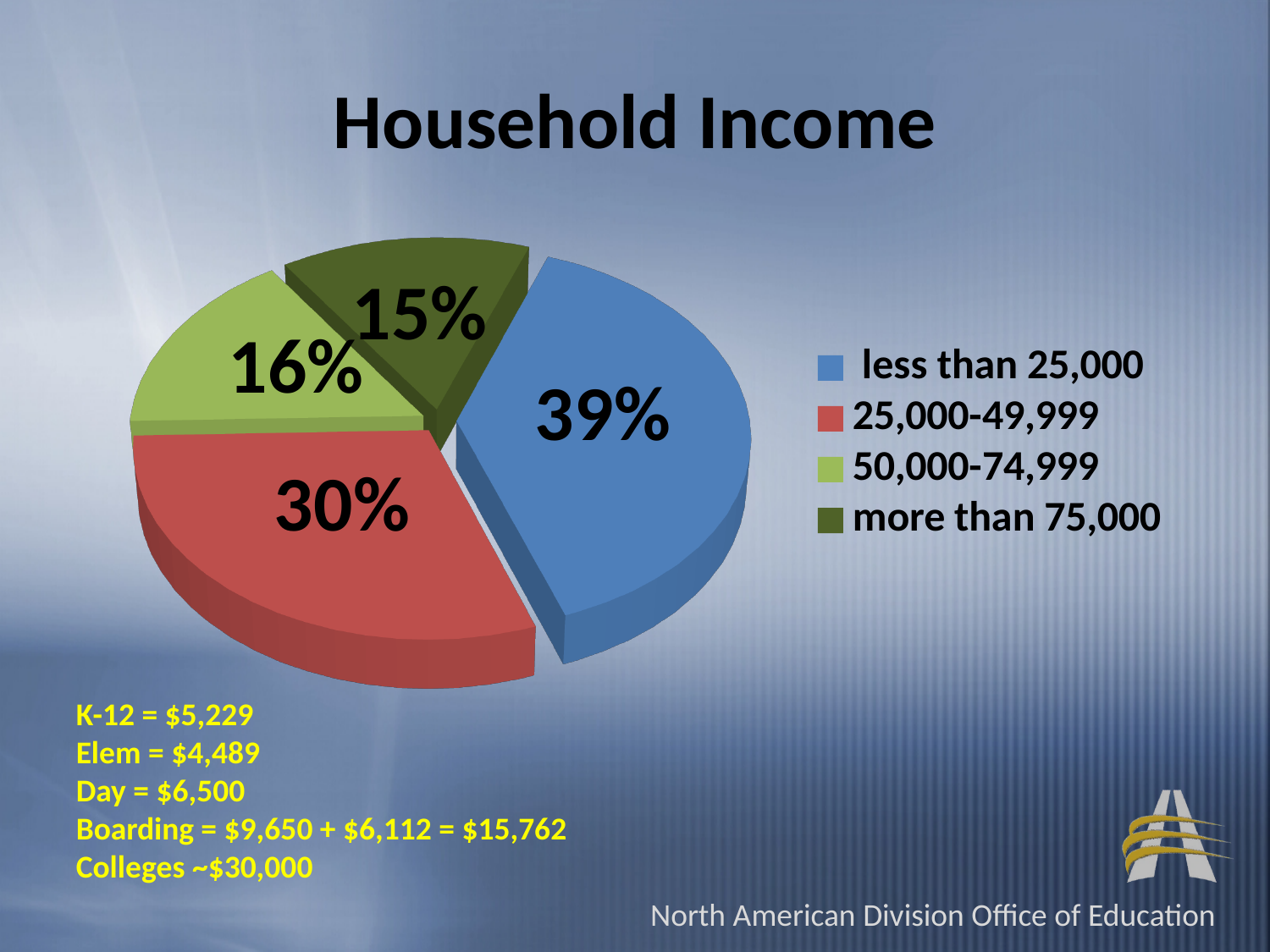
What percentage is shown for the '50,000-74,999' category? 16% What colour is the slice for 'less than 25,000'? blue Which is larger, the share for '25,000-49,999' or the share for '50,000-74,999'? 25,000-49,999 What percentage is shown for the 'more than 75,000' category? 15% Which income category has the smallest share of the pie? more than 75,000 What is the difference in percentage points between the 'less than 25,000' and '25,000-49,999' slices? 9 What kind of chart is shown on the slide? pie chart What percentage is shown for the '25,000-49,999' category? 30% What share of the pie does the 'less than 25,000' slice represent? 39% Which income category has the largest share of the pie? less than 25,000 What is the title of the chart? Household Income How many categories does the pie chart show? 4